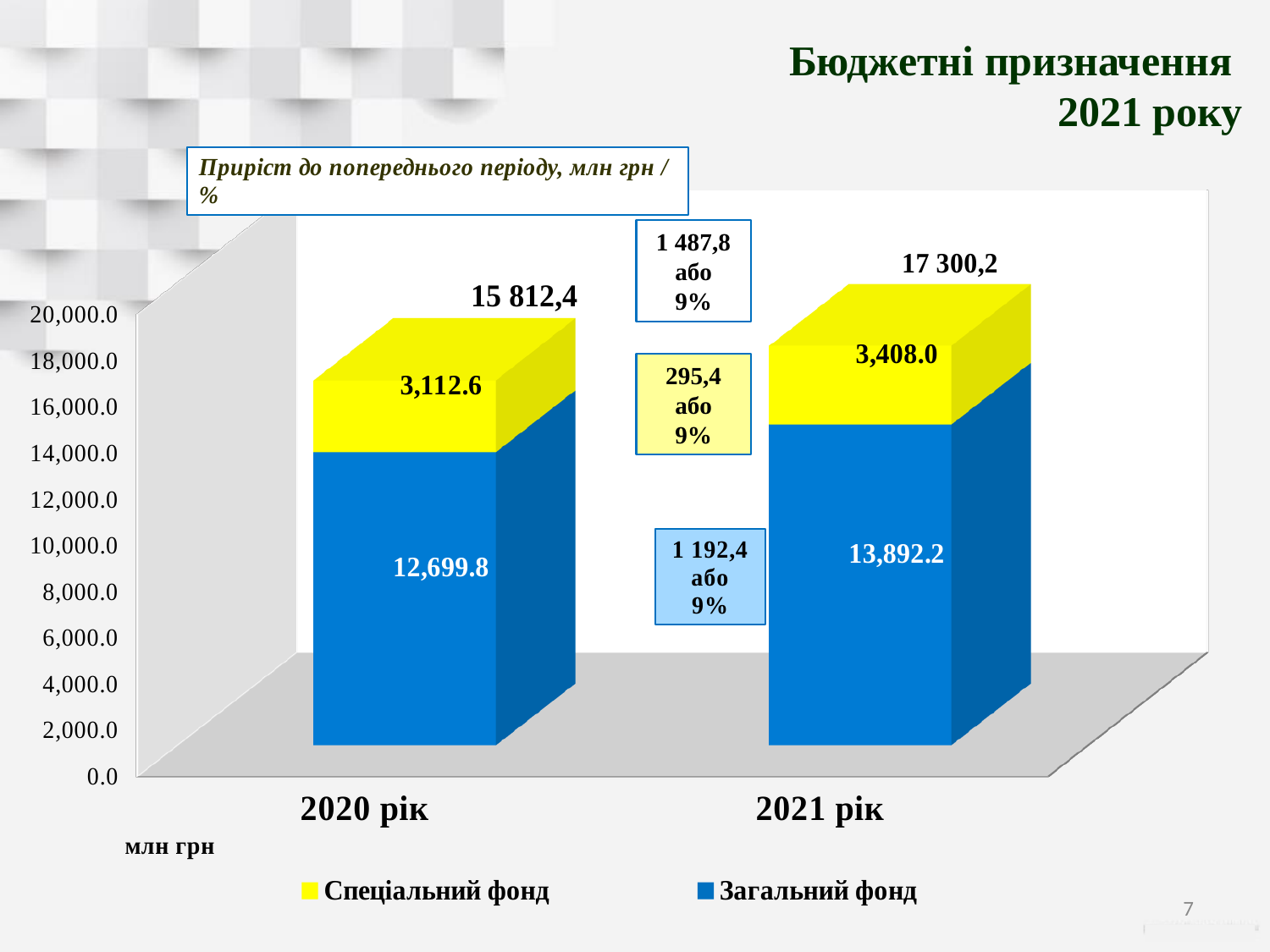
What kind of chart is shown on the slide? Stacked bar chart What is the value of Спеціальний фонд for 2021 рік? 3,408.0 Which colour represents Спеціальний фонд in the legend? Yellow What is the total of the stacked bar for 2021 рік? 17 300,2 How many categories are shown on the x axis? 2 Which year has the larger value for Загальний фонд, 2020 рік or 2021 рік? 2021 рік What is the difference between the Загальний фонд values for 2021 рік and 2020 рік? 1 192,4 What is the value of Загальний фонд for 2020 рік? 12,699.8 What is the value of Загальний фонд for 2021 рік? 13,892.2 What is the value of Спеціальний фонд for 2020 рік? 3,112.6 How many series does the legend list? 2 What is the total of the stacked bar for 2020 рік? 15 812,4